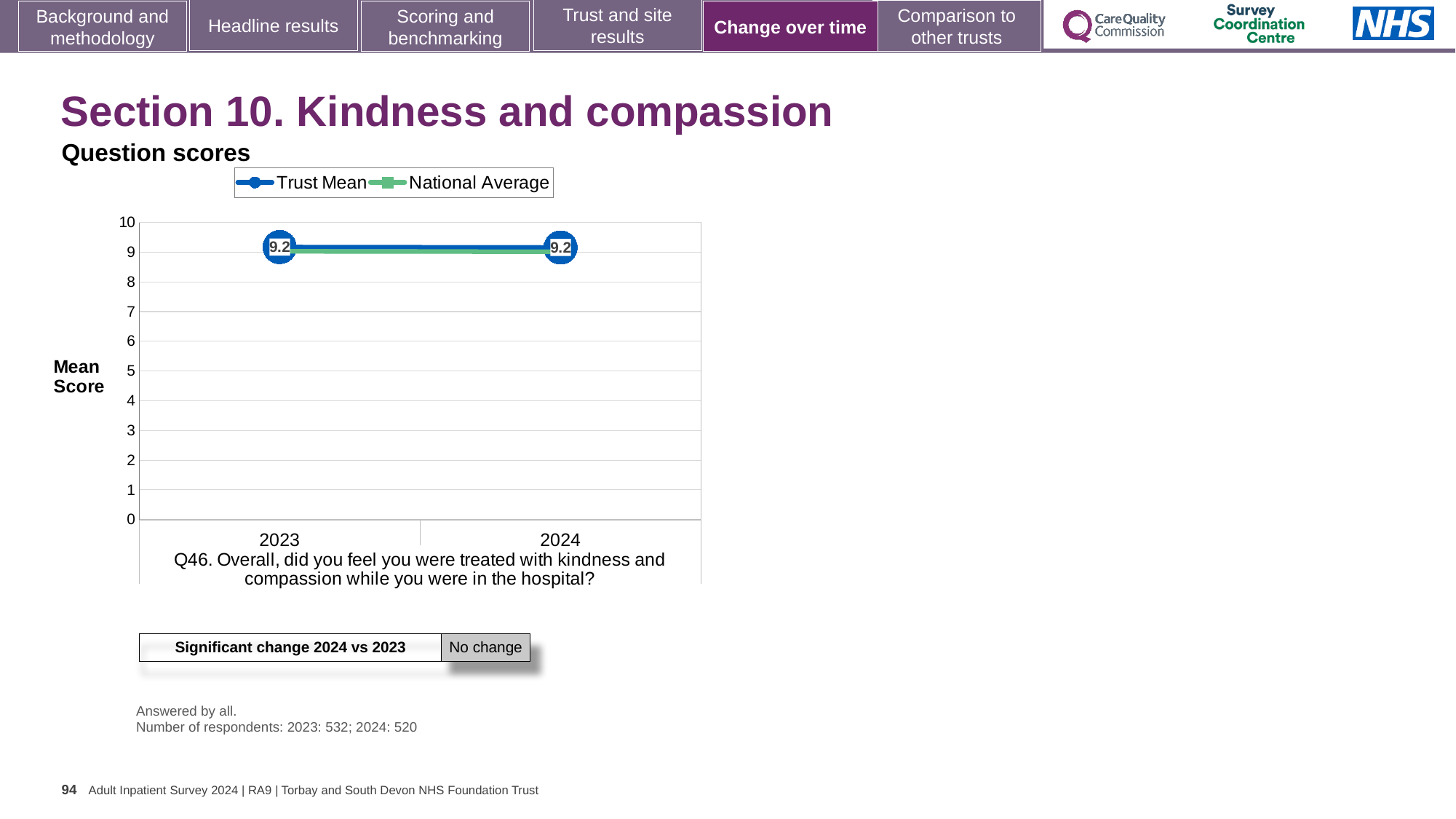
What kind of chart is shown on the slide? line chart What is the difference between the Trust Mean for 2024 and the Trust Mean for 2023? 0 Is the National Average value for 2024 greater or less than 8? greater Does the Trust Mean rise, fall, or stay the same from 2023 to 2024? stays the same Is the Trust Mean value for 2023 greater or less than 8? greater What are the two series named in the chart legend? Trust Mean and National Average How many series does the chart legend list? 2 Is the National Average value for 2023 greater or less than 5? greater What is the Trust Mean value for 2024? 9.2 What is the label on the y axis of the chart? Mean Score What is the Trust Mean value for 2023? 9.2 How many years are plotted on the x axis of the chart? 2